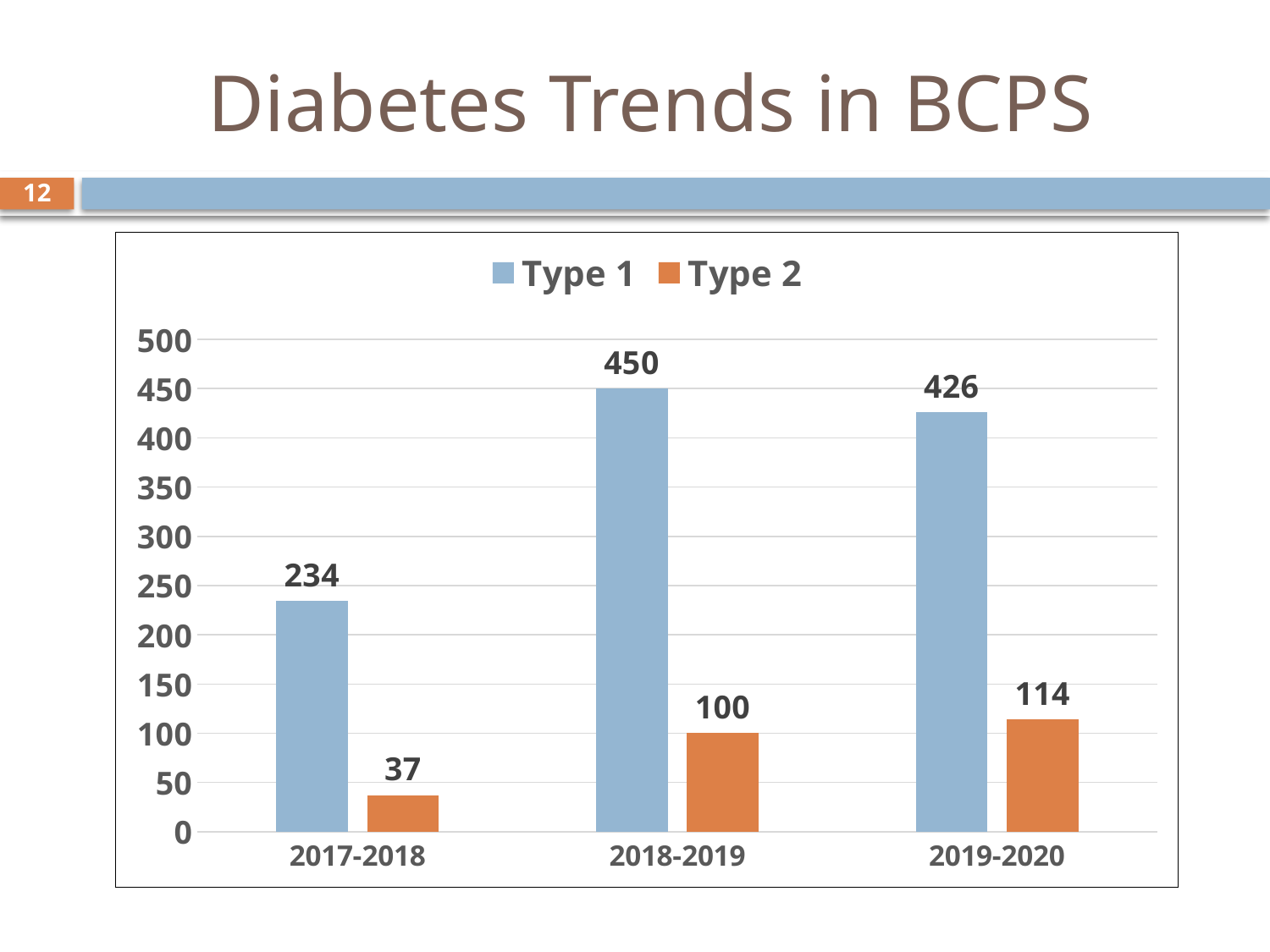
What is the Type 2 value for 2019-2020? 114 What is the difference between the Type 1 and Type 2 values for 2019-2020? 312 What is the Type 1 value for 2018-2019? 450 What is the Type 2 value for 2017-2018? 37 Does the Type 2 value rise or fall from 2017-2018 to 2019-2020? rise Which school year has the highest Type 1 value? 2018-2019 Which is larger, the Type 1 value for 2017-2018 or the Type 1 value for 2019-2020? 2019-2020 What kind of chart is shown on the slide? bar chart How many series does the legend list? 2 How many school years are shown on the x axis? 3 Which school year has the lowest Type 2 value? 2017-2018 Is the Type 1 value for 2017-2018 greater or less than 200? greater